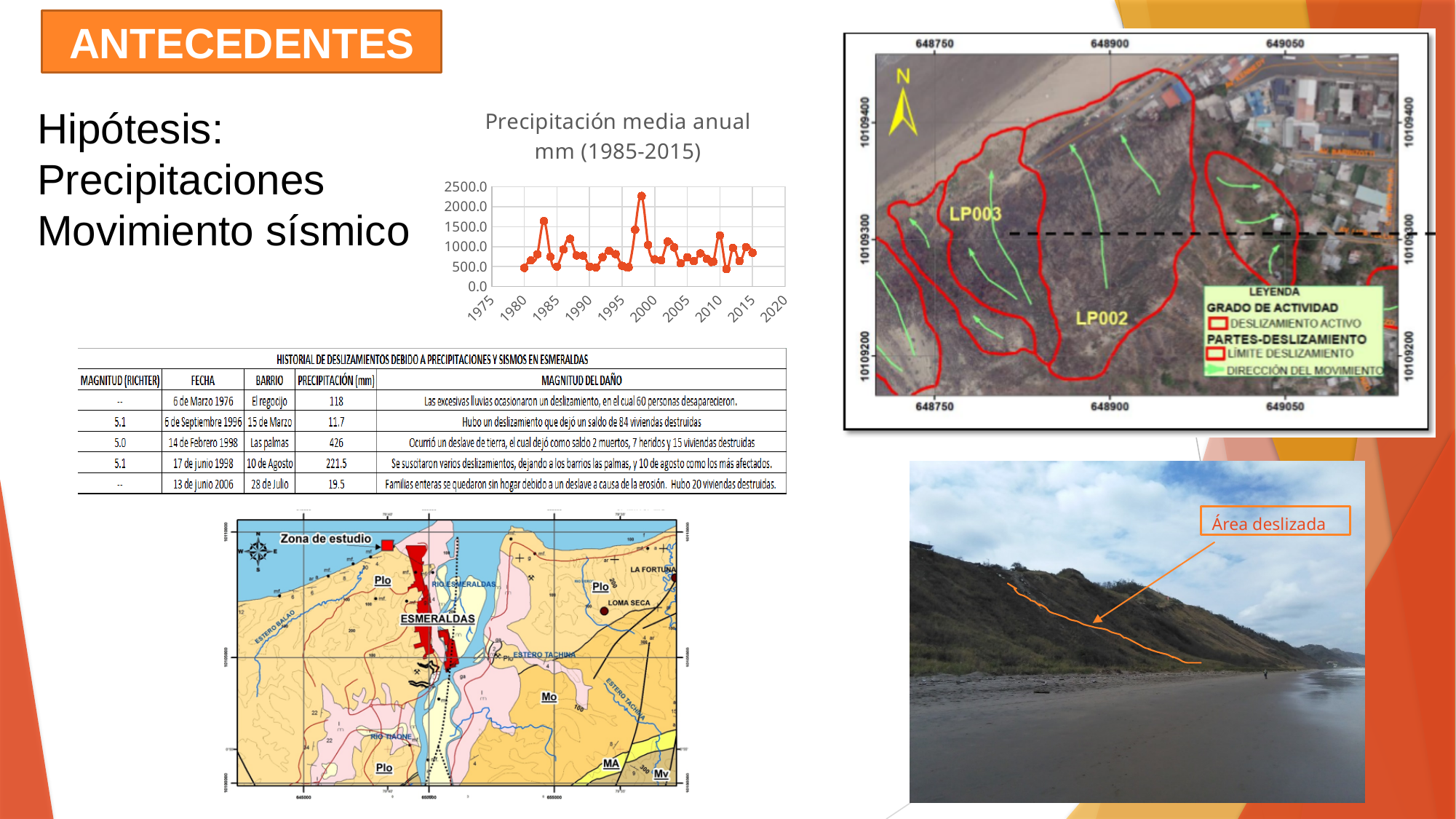
In the 'Precipitación media anual' chart, is the peak between 1995 and 2000 higher or lower than the peak between 1980 and 1985? higher What is the title of the chart on the slide? Precipitación media anual mm (1985-2015) In the 'Precipitación media anual' chart, is the highest plotted value greater or less than 2000.0? greater In the 'Precipitación media anual' chart, is the first plotted value (around 1981) greater or less than 1000.0? less In the 'Precipitación media anual' chart, is the peak value that occurs between 1980 and 1985 greater or less than 1500.0? greater In the 'Precipitación media anual' chart, does the highest peak occur before or after 1995? after What kind of chart is the 'Precipitación media anual mm (1985-2015)' chart? line chart What is the highest tick value shown on the y-axis of the 'Precipitación media anual' chart? 2500.0